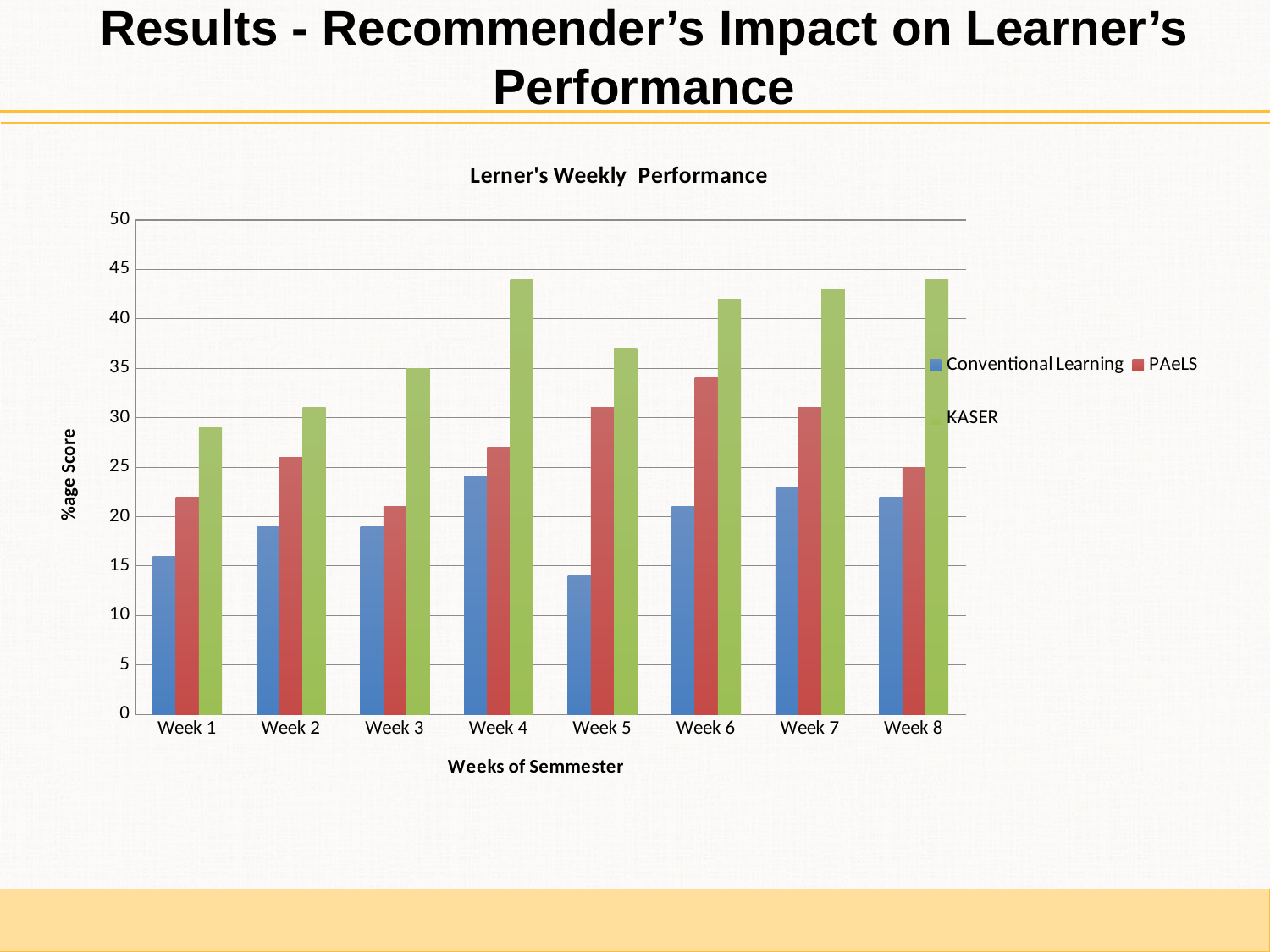
In which week is the PAeLS value highest? Week 6 Is the Conventional Learning value for Week 1 greater or less than 20? less Is the KASER value for Week 4 greater or less than 40? greater How many series does the legend list? 3 Is the PAeLS value for Week 6 greater or less than 30? greater In Week 5, which is larger: Conventional Learning or PAeLS? PAeLS What is the title of the chart? Lerner's Weekly Performance What is the label on the y axis? %age Score In which week is the Conventional Learning value lowest? Week 5 In Week 4, which is larger: KASER or PAeLS? KASER What type of chart is shown on the slide? Bar chart How many weeks are shown on the x axis? 8